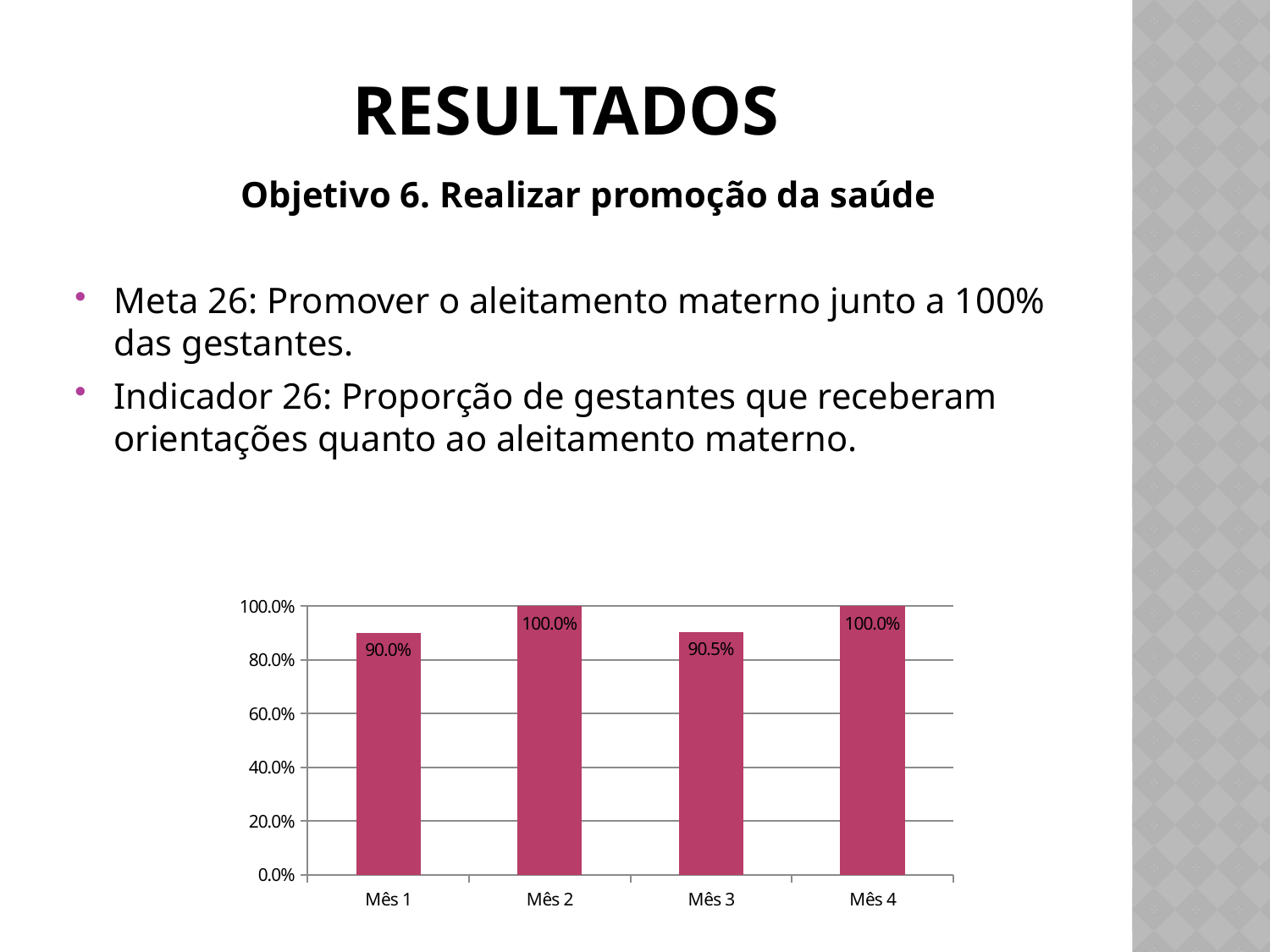
What is the value for Mês 4? 100.0% What is the value for Mês 1? 90.0% Is the value for Mês 1 greater or less than 80.0%? greater Does the value rise or fall from Mês 1 to Mês 2? rise How many months are shown on the x axis of the chart? 4 What kind of chart is shown on the slide? bar chart What is the value for Mês 2? 100.0% Which months reach the highest value of 100.0%? Mês 2 and Mês 4 What is the value for Mês 3? 90.5% What is the difference between the values for Mês 2 and Mês 1? 10.0% Which is larger, the value for Mês 2 or the value for Mês 3? Mês 2 What is the difference between the values for Mês 4 and Mês 3? 9.5%